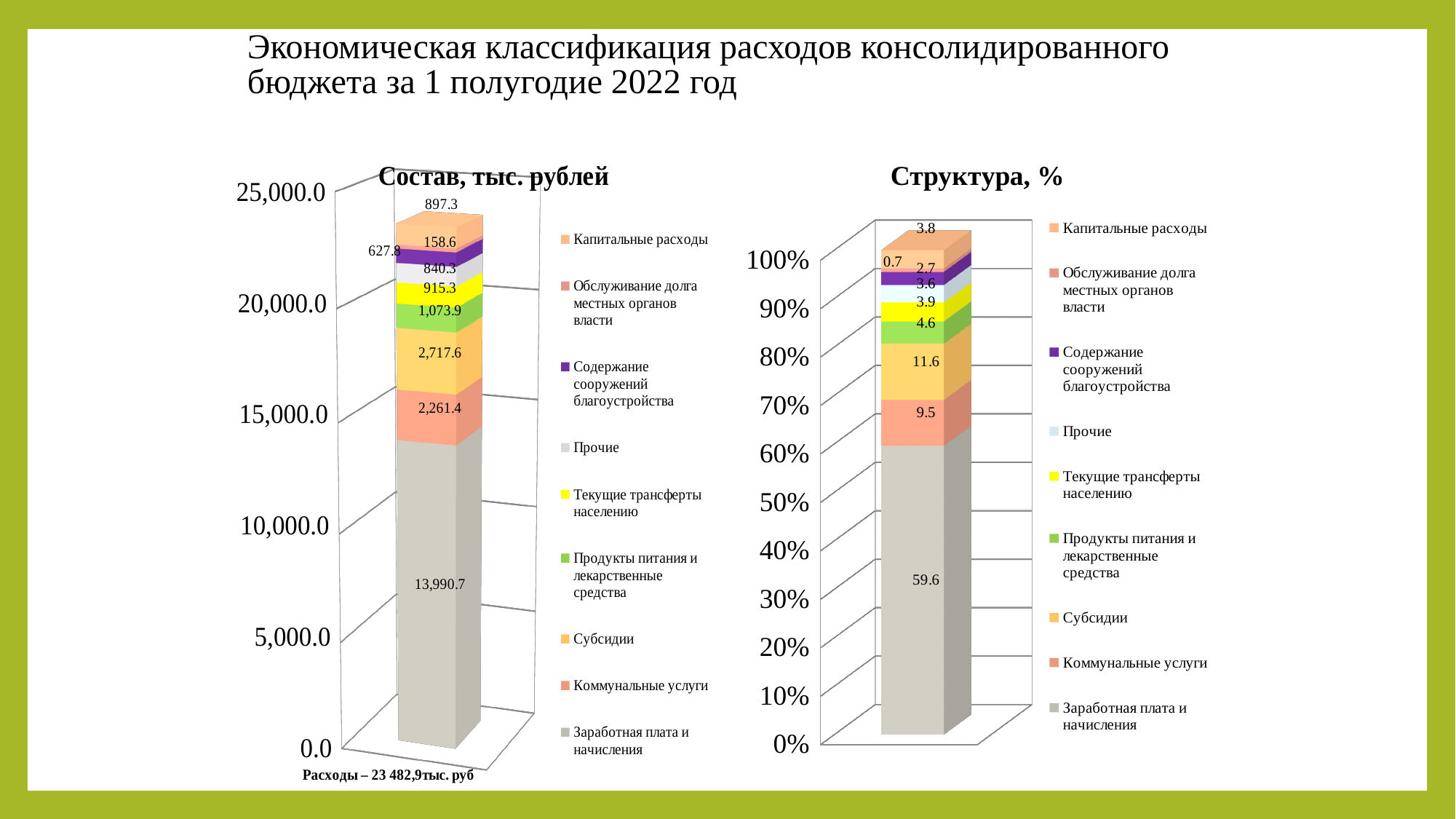
In the chart titled "Структура, %", what is the difference between the values for "Заработная плата и начисления" and "Коммунальные услуги"? 50.1 In the chart titled "Структура, %", what is the value for "Субсидии"? 11.6 In the chart titled "Состав, тыс. рублей", what is the difference between the values for "Субсидии" and "Коммунальные услуги"? 456.2 In the chart titled "Состав, тыс. рублей", which category has the largest value? Заработная плата и начисления In the chart titled "Состав, тыс. рублей", what is the value for "Заработная плата и начисления"? 13,990.7 How many series does the legend of the chart titled "Состав, тыс. рублей" list? 9 In the chart titled "Состав, тыс. рублей", what is the value for "Продукты питания и лекарственные средства"? 1,073.9 What kind of chart is the chart titled "Структура, %"? Stacked bar chart In the chart titled "Структура, %", which category has the smallest value? Обслуживание долга местных органов власти In the chart titled "Состав, тыс. рублей", what is the total of the stacked bar? 23 482,9 тыс. руб In the chart titled "Структура, %", what is the value for "Капитальные расходы"? 3.8 In the chart titled "Структура, %", which is larger: "Коммунальные услуги" or "Субсидии"? Субсидии